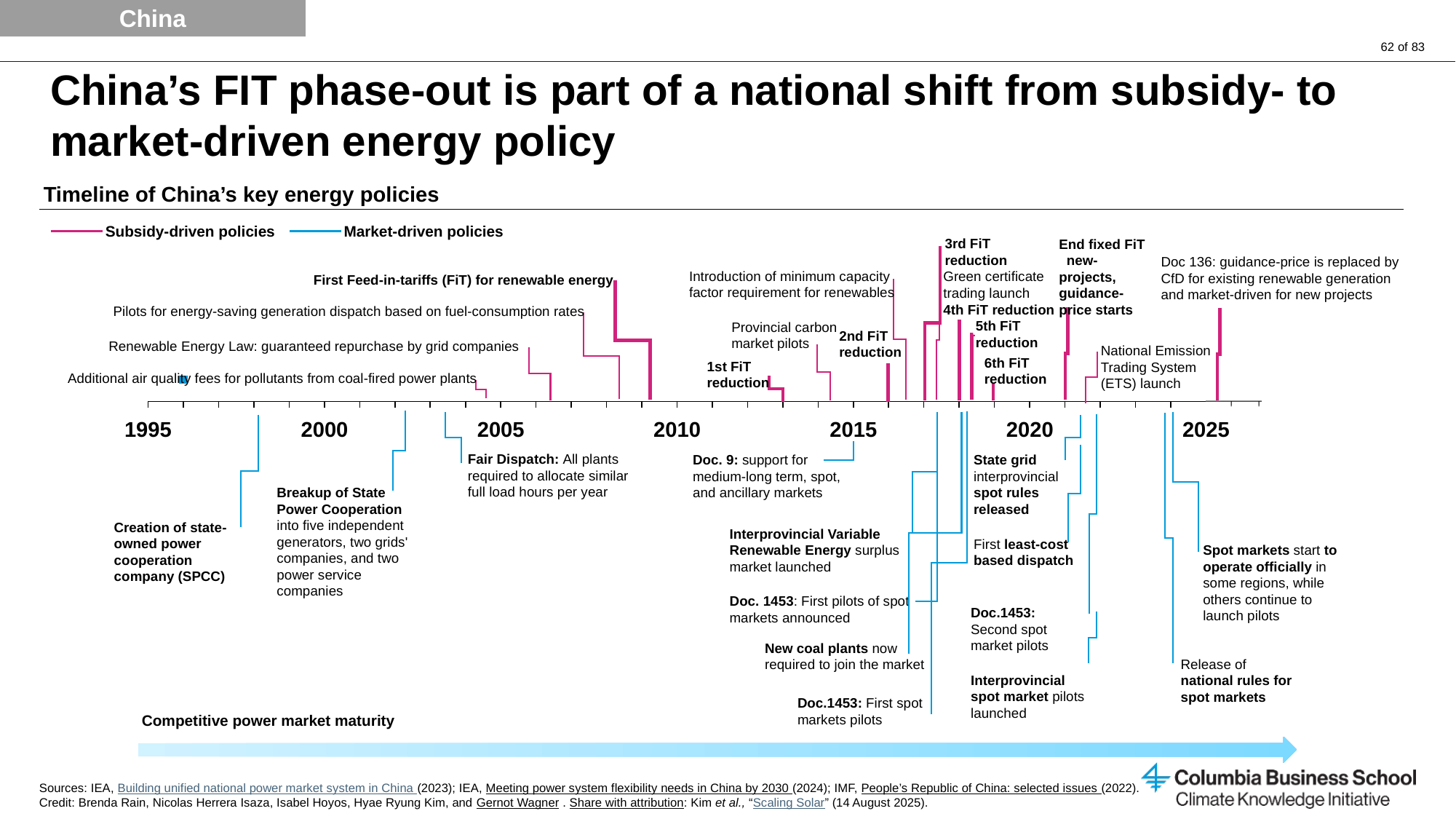
What kind of chart is shown on the slide? Timeline chart How many FiT reductions are marked on the timeline? 6 Is the 'First Feed-in-tariffs (FiT) for renewable energy' event placed before or after 2010 on the timeline? Before What is the title of the timeline chart? Timeline of China's key energy policies How many series does the legend of the timeline list? 2 Which event is labeled at the far left below the timeline axis? Creation of state-owned power cooperation company (SPCC) What is the first year label on the timeline's axis? 1995 Which occurs earlier on the timeline: the creation of SPCC or the breakup of State Power Cooperation? Creation of SPCC Which occurs earlier on the timeline: the 1st FiT reduction or the 6th FiT reduction? 1st FiT reduction What is the last year label on the timeline's axis? 2025 How many year labels are shown along the timeline's axis? 7 Which colour represents market-driven policies in the timeline? Blue